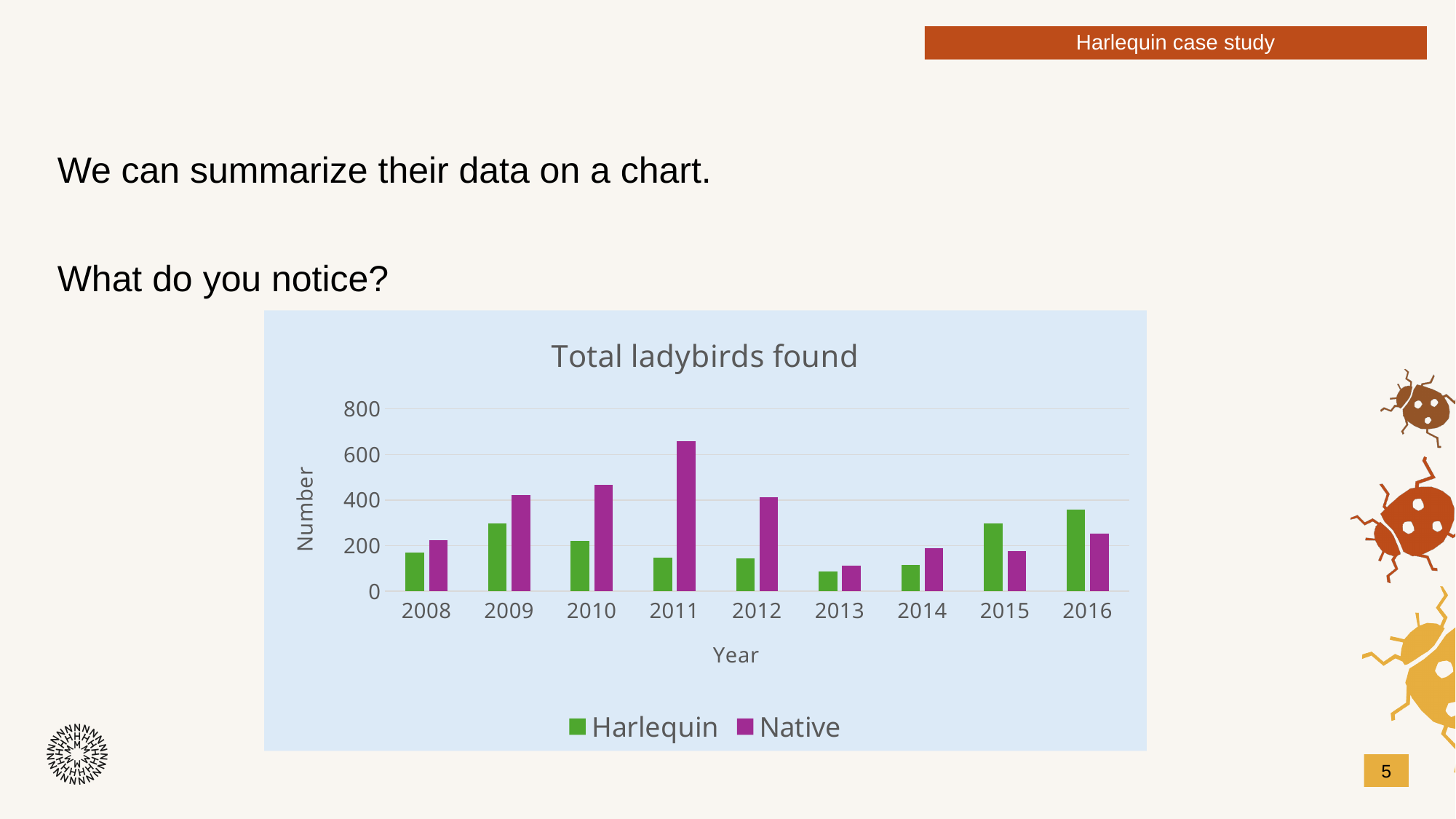
In which year is the Native value lowest? 2013 How many series does the legend list? 2 Is the Native value for 2010 greater or less than 400? greater In 2011, which series has the larger value, Harlequin or Native? Native What is the title of the chart? Total ladybirds found What kind of chart is shown on the slide? bar chart In 2016, which series has the larger value, Harlequin or Native? Harlequin In which year is the Harlequin value highest? 2016 How many years are shown on the x axis? 9 In which year is the Native value highest? 2011 Is the Harlequin value for 2013 greater or less than 200? less Is the Native value for 2011 greater or less than 600? greater